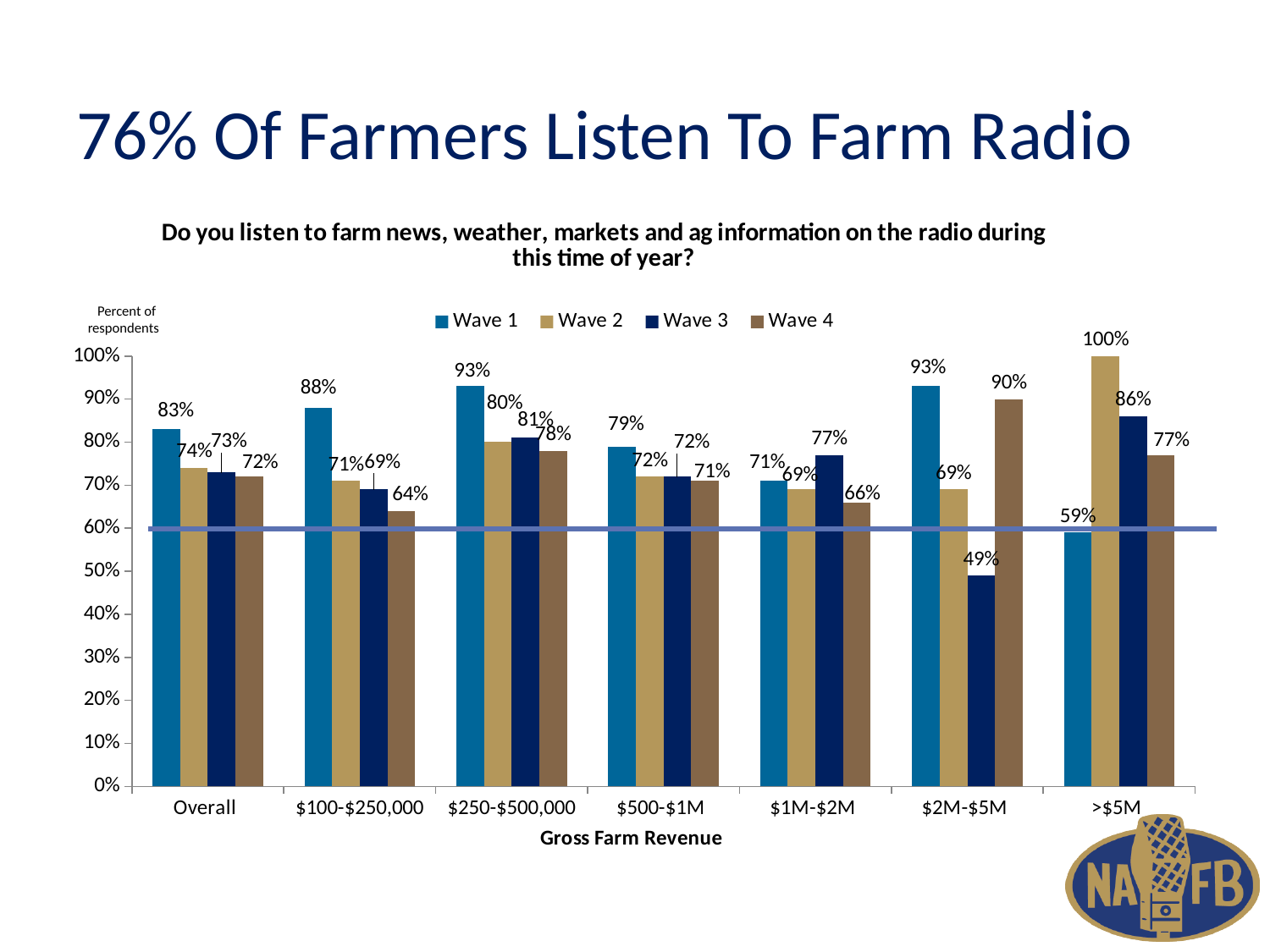
How many gross farm revenue categories are shown on the x axis? 7 What is the Wave 4 value for the $250-$500,000 category? 78% What is the Wave 1 value for the Overall category? 83% How many series does the legend list? 4 What is the Wave 3 value for the $2M-$5M category? 49% What is the Wave 2 value for the >$5M category? 100% What kind of chart is shown on the slide? Bar chart For the $1M-$2M category, which is larger: the Wave 2 value or the Wave 3 value? Wave 3 What is the difference between the Wave 1 and Wave 4 values for the $100-$250,000 category? 24 percentage points Which gross farm revenue category has the lowest Wave 1 value? >$5M What is the title of the x axis? Gross Farm Revenue Which gross farm revenue category has the highest Wave 4 value? $2M-$5M